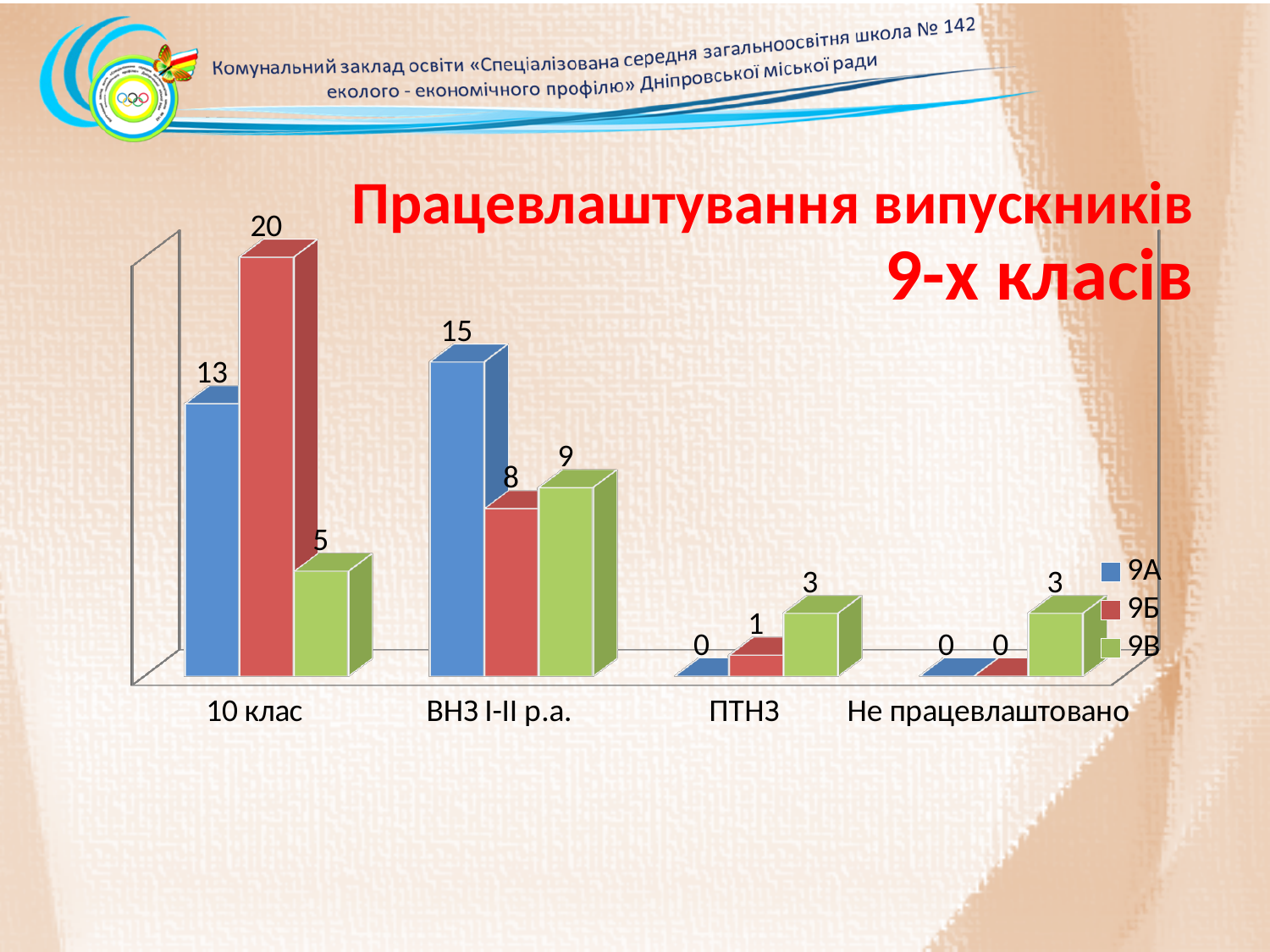
What is the value for 9Б in the 10 клас category? 20 What is the value for 9В in the ПТНЗ category? 3 What is the title of the slide's chart? Працевлаштування випускників 9-х класів Which category has the lowest value for 9В? ПТНЗ and Не працевлаштовано (both 3) How many series does the legend list? 3 How many categories are shown on the x axis? 4 What is the value for 9Б in the Не працевлаштовано category? 0 What is the difference between the 9Б and 9А values in the 10 клас category? 7 Which category has the highest value for 9Б? 10 клас What is the value for 9А in the ВНЗ І-ІІ р.а. category? 15 What kind of chart is shown on the slide? Bar chart Which is larger in the ВНЗ І-ІІ р.а. category: 9Б or 9В? 9В